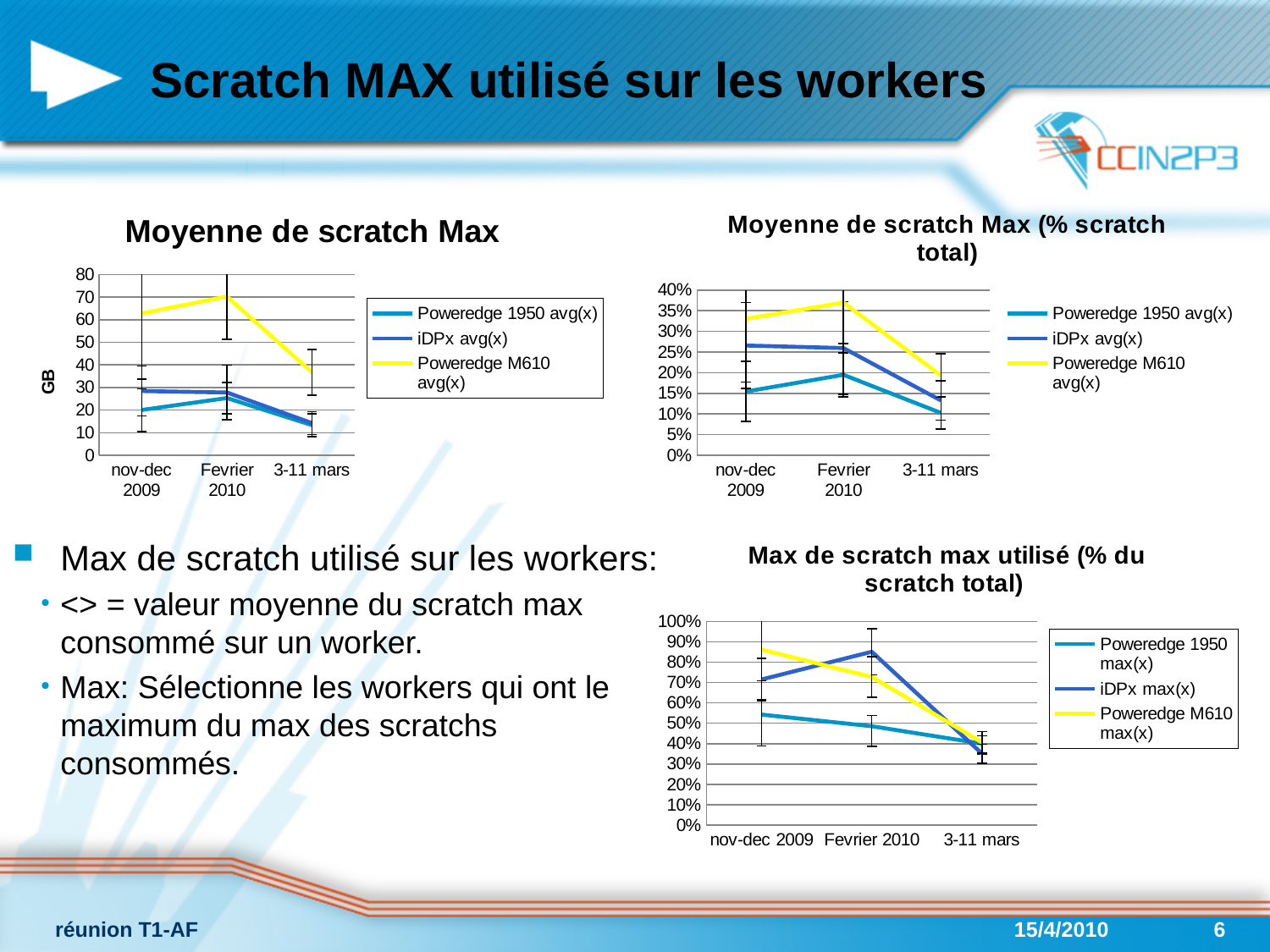
In the 'Moyenne de scratch Max' chart, which series is highest at Fevrier 2010? Poweredge M610 avg(x) In the 'Moyenne de scratch Max' chart, is the value for Poweredge M610 avg(x) at Fevrier 2010 greater or less than 60? greater In the 'Max de scratch max utilisé (% du scratch total)' chart, does the Poweredge 1950 max(x) series rise or fall from nov-dec 2009 to 3-11 mars? fall How many categories are shown on the x axis of the 'Moyenne de scratch Max (% scratch total)' chart? 3 What is the y-axis label of the 'Moyenne de scratch Max' chart? GB In the 'Max de scratch max utilisé (% du scratch total)' chart, which series is highest at Fevrier 2010? iDPx max(x) What kind of chart is the 'Moyenne de scratch Max' chart? line chart In the 'Moyenne de scratch Max (% scratch total)' chart, which series is lowest at 3-11 mars? Poweredge 1950 avg(x) In the 'Moyenne de scratch Max (% scratch total)' chart, is the value for Poweredge M610 avg(x) at Fevrier 2010 greater or less than 30%? greater How many series does the legend of the 'Moyenne de scratch Max' chart list? 3 In the 'Max de scratch max utilisé (% du scratch total)' chart, is the value for iDPx max(x) at Fevrier 2010 greater or less than 80%? greater